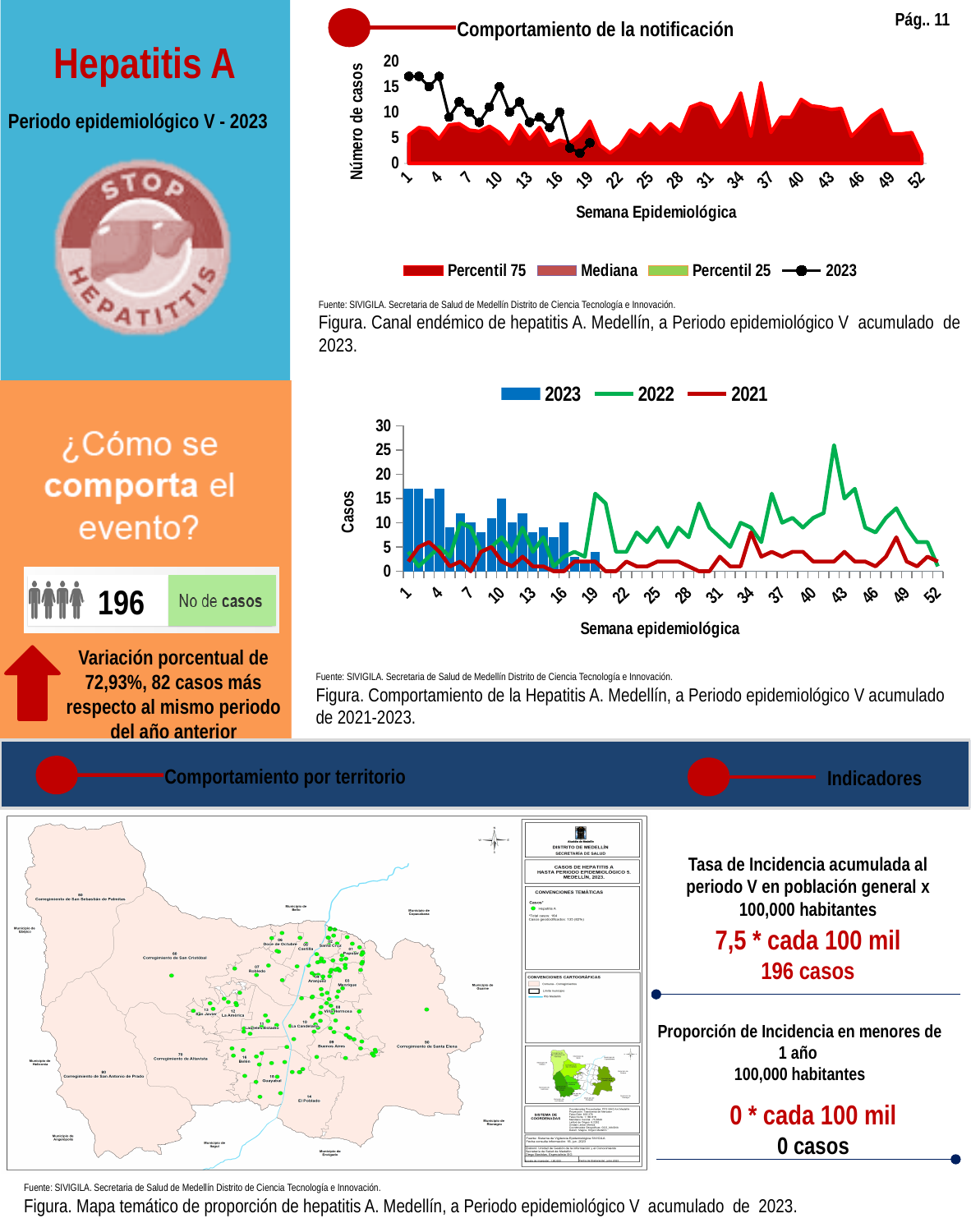
In the middle chart comparing 2021, 2022 and 2023, is the highest value of the 2022 line greater or less than 20? greater In the chart titled 'Comportamiento de la notificación', how many series does the legend list? 4 In the chart titled 'Comportamiento de la notificación', which series is drawn as a black line with markers? 2023 In the middle chart comparing 2021, 2022 and 2023, is the 2023 value at week 1 greater or less than 15? greater In the middle chart comparing 2021, 2022 and 2023, which is larger at week 1: the 2023 value or the 2021 value? 2023 In the middle chart comparing 2021, 2022 and 2023, what kind of chart is used for the 2023 series? bar chart In the chart titled 'Comportamiento de la notificación', does the 2023 line generally rise or fall from week 1 to week 19? fall In the chart titled 'Comportamiento de la notificación', what is the label of the y axis? Número de casos In the middle chart comparing 2021, 2022 and 2023, how many series does the legend list? 3 In the chart titled 'Comportamiento de la notificación', is the 2023 value at week 1 greater or less than 15? greater